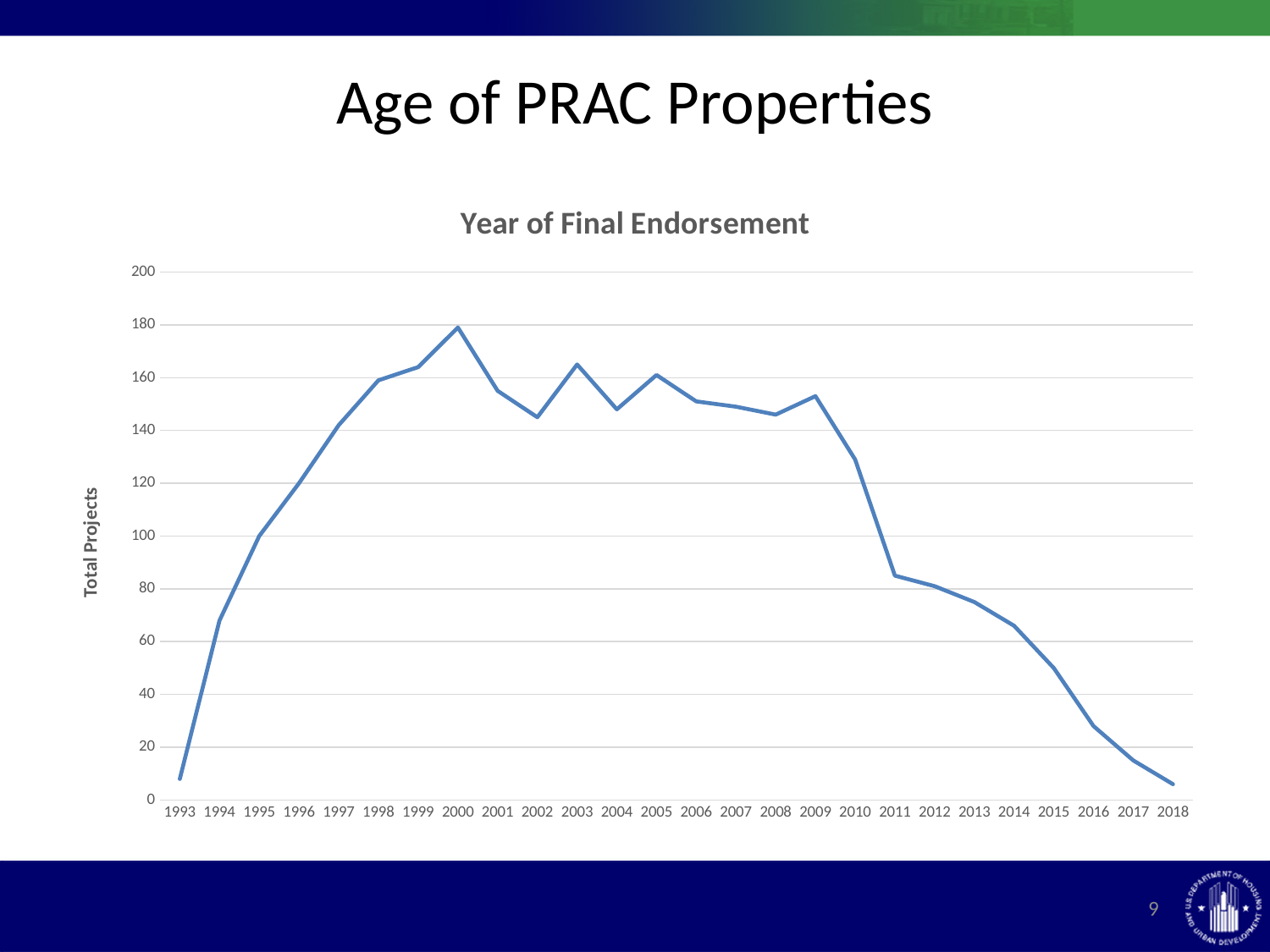
What kind of chart is shown on the slide? line chart Is the value for 1993 greater or less than 20? less Which year has the larger value, 1995 or 2015? 1995 Is the value for 2016 greater or less than 20? greater What is the title of the chart? Year of Final Endorsement Is the value for 2000 greater or less than 160? greater What is the label on the vertical axis of the chart? Total Projects Which year has the highest number of total projects? 2000 Which year has the larger value, 2003 or 2002? 2003 How many years are plotted along the x axis of the chart? 26 Do the values rise or fall from 2009 to 2018? fall